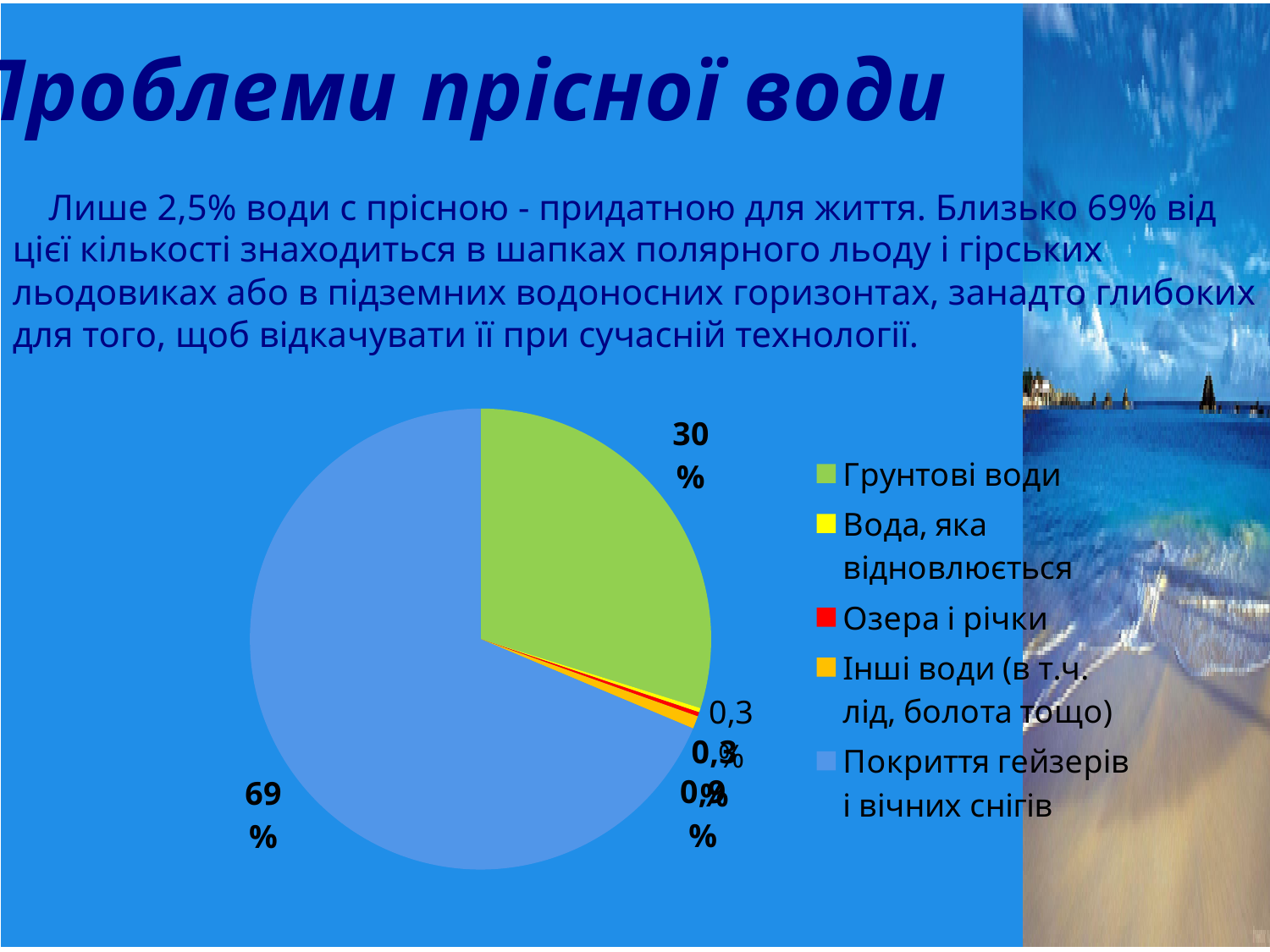
Which category has the largest slice of the pie? Покриття гейзерів і вічних снігів What colour is the slice for Озера і річки according to the legend? red What percentage of the pie is labelled for Покриття гейзерів і вічних снігів? 69% What percentage of the pie is labelled for Грунтові води? 30% Which is larger: the slice for Грунтові води or the slice for Покриття гейзерів і вічних снігів? Покриття гейзерів і вічних снігів What kind of chart is shown on the slide? pie chart How many categories does the legend of the pie chart list? 5 What colour is the slice for Грунтові води? green By how many percentage points does the slice for Покриття гейзерів і вічних снігів exceed the slice for Грунтові води? 39